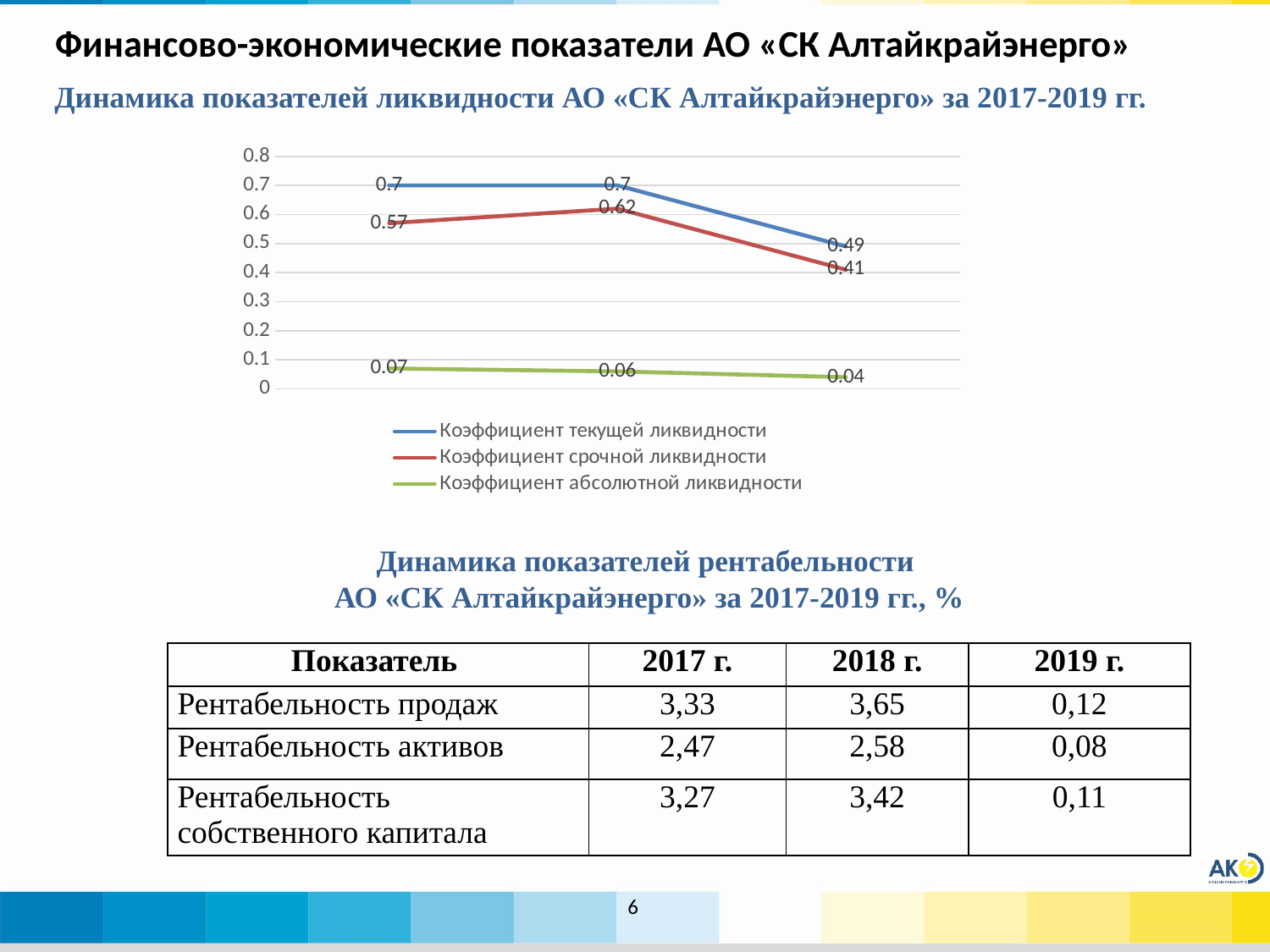
What is the value of Коэффициент абсолютной ликвидности at the first point? 0.07 At the third (last) point, what is the difference between Коэффициент текущей ликвидности and Коэффициент срочной ликвидности? 0.08 What is the lowest value plotted for Коэффициент абсолютной ликвидности? 0.04 At the first point, which is larger: Коэффициент текущей ликвидности or Коэффициент срочной ликвидности? Коэффициент текущей ликвидности What kind of chart is shown on the slide? line chart How many data points does each series in the chart have? 3 Which series is drawn with the blue line in the chart? Коэффициент текущей ликвидности What is the value of Коэффициент текущей ликвидности at the third (last) point? 0.49 What is the highest value plotted for Коэффициент срочной ликвидности? 0.62 What is the value of Коэффициент срочной ликвидности at the second (middle) point? 0.62 Does Коэффициент абсолютной ликвидности rise or fall from the first point to the last point? fall How many series does the chart legend list? 3